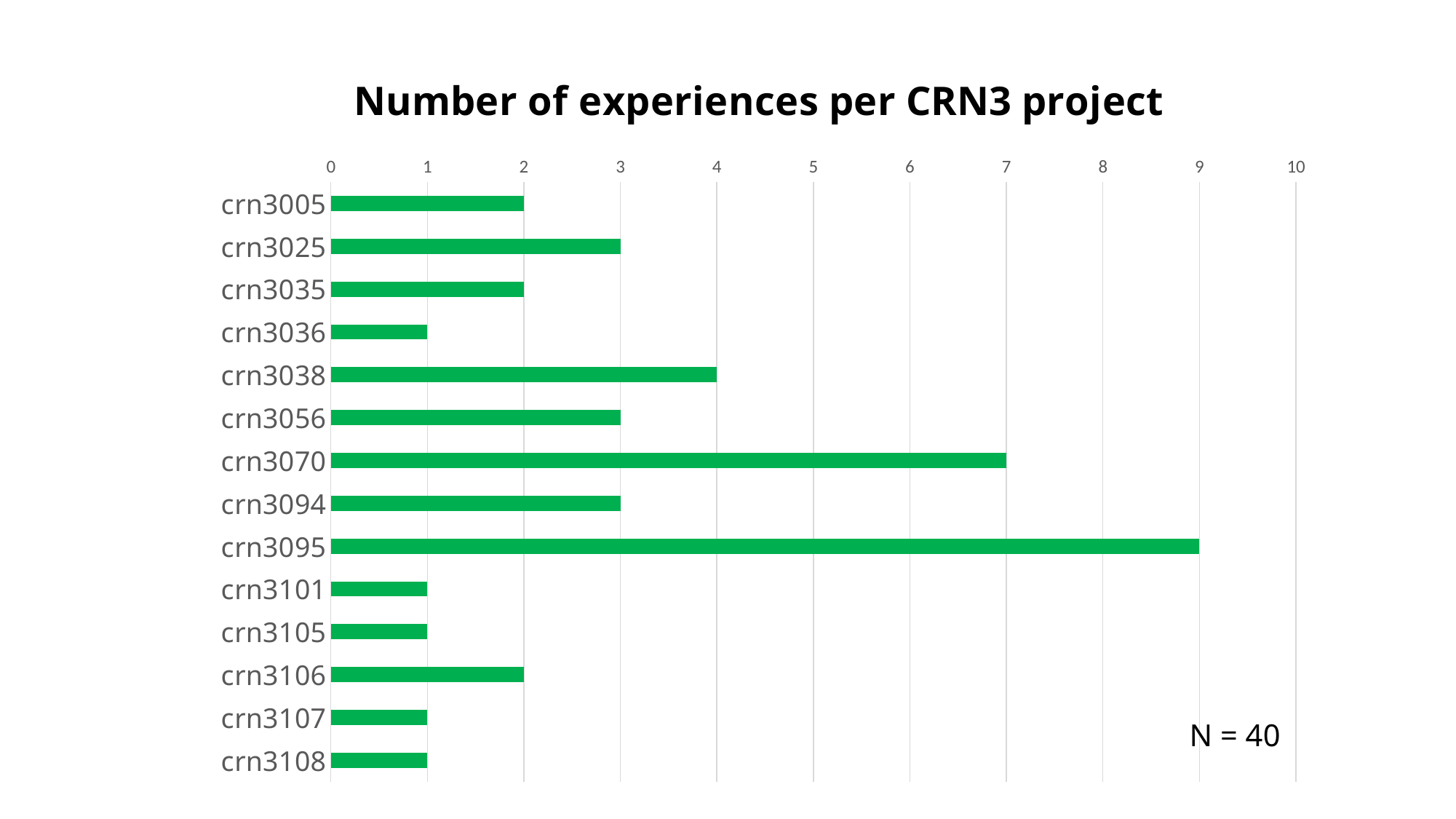
Is the value for crn3070 greater or less than 5? greater What is the number of experiences for crn3038? 4 What is the difference in number of experiences between crn3095 and crn3070? 2 What kind of chart is shown on the slide? Bar chart What is the value of N shown on the slide? N = 40 How many CRN3 projects are shown on the chart? 14 What is the number of experiences for crn3070? 7 What is the number of experiences for crn3095? 9 Which has more experiences, crn3038 or crn3025? crn3038 What is the number of experiences for crn3036? 1 Which CRN3 project has the highest number of experiences? crn3095 What is the title of the chart? Number of experiences per CRN3 project